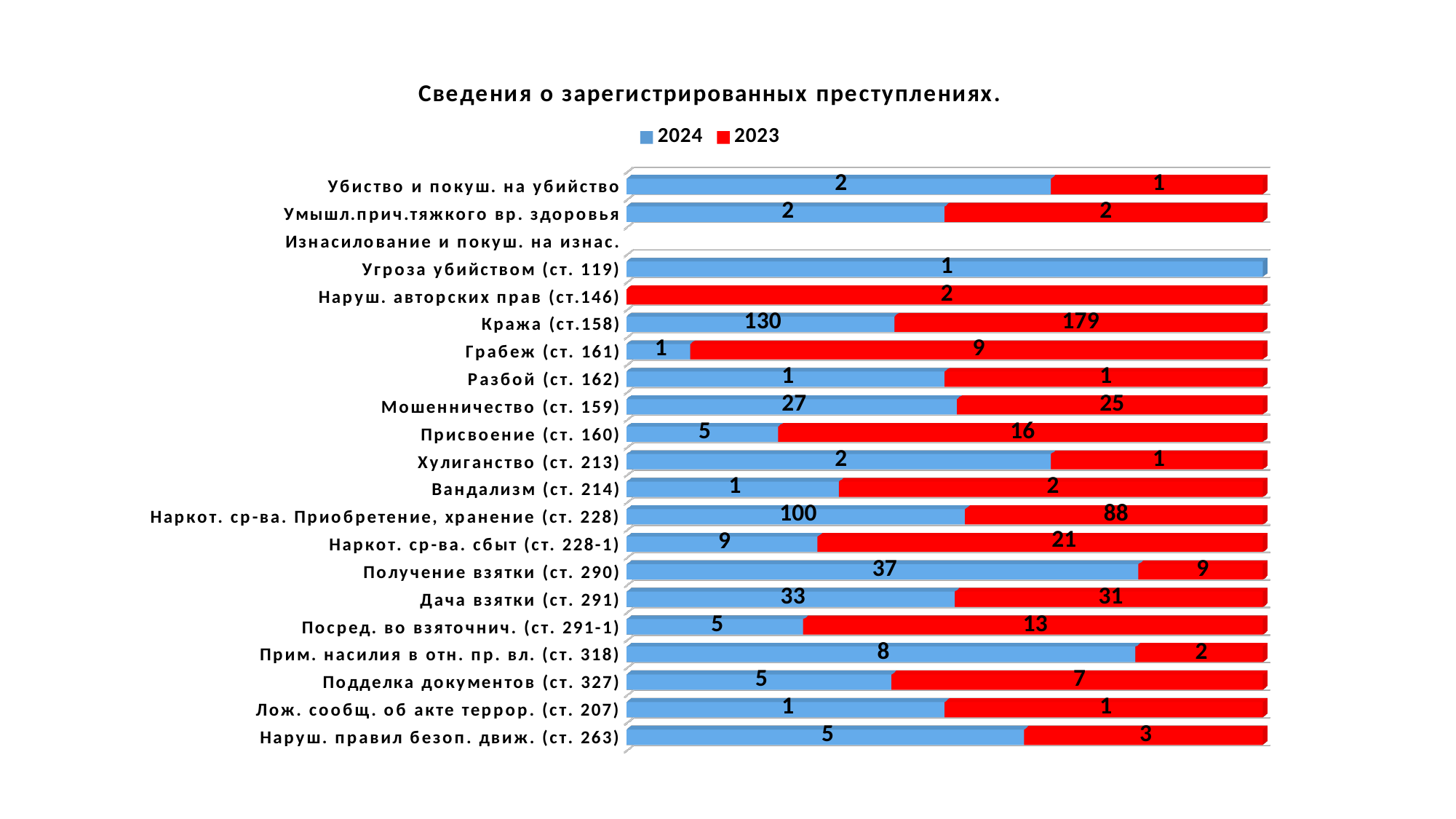
How many series does the legend list? 2 What is the title of the chart? Сведения о зарегистрированных преступлениях. What is the combined total of the 2024 and 2023 values for Дача взятки (ст. 291)? 64 What is the 2023 value for Наркот. ср-ва. сбыт (ст. 228-1)? 21 Which category has the highest 2023 value? Кража (ст.158) Which is larger for Присвоение (ст. 160): the 2024 value or the 2023 value? 2023 What is the difference between the 2023 and 2024 values for Кража (ст.158)? 49 What is the 2024 value for Получение взятки (ст. 290)? 37 What kind of chart is shown on the slide? Stacked horizontal bar chart Which category has the highest 2024 value? Кража (ст.158) What is the difference between the 2024 and 2023 values for Наркот. ср-ва. Приобретение, хранение (ст. 228)? 12 What is the 2024 value for Кража (ст.158)? 130